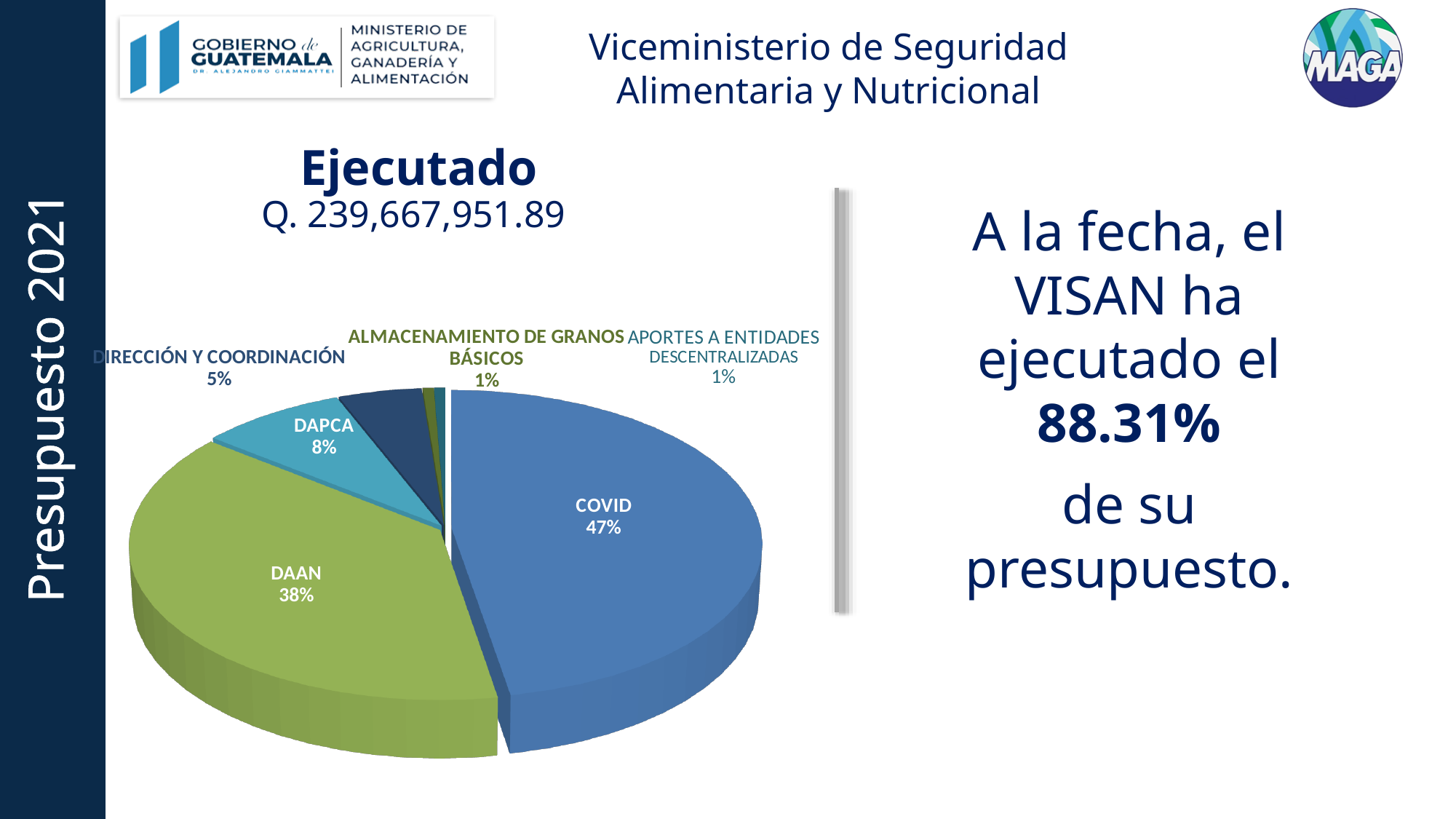
What kind of chart is shown on the slide? Pie chart What is the value shown for DIRECCIÓN Y COORDINACIÓN? 5% What is the difference in percentage points between COVID and DAAN? 9% What is the value shown for DAPCA? 8% Which is larger, the DAPCA slice or the DIRECCIÓN Y COORDINACIÓN slice? DAPCA What is the value shown for ALMACENAMIENTO DE GRANOS BÁSICOS? 1% Which category has the largest slice of the pie? COVID What share of the pie does DAAN represent? 38% What share of the pie does COVID represent? 47% What is the difference in percentage points between DAAN and DAPCA? 30% How many slices does the pie chart have? 6 What total executed amount is shown above the chart? Q. 239,667,951.89